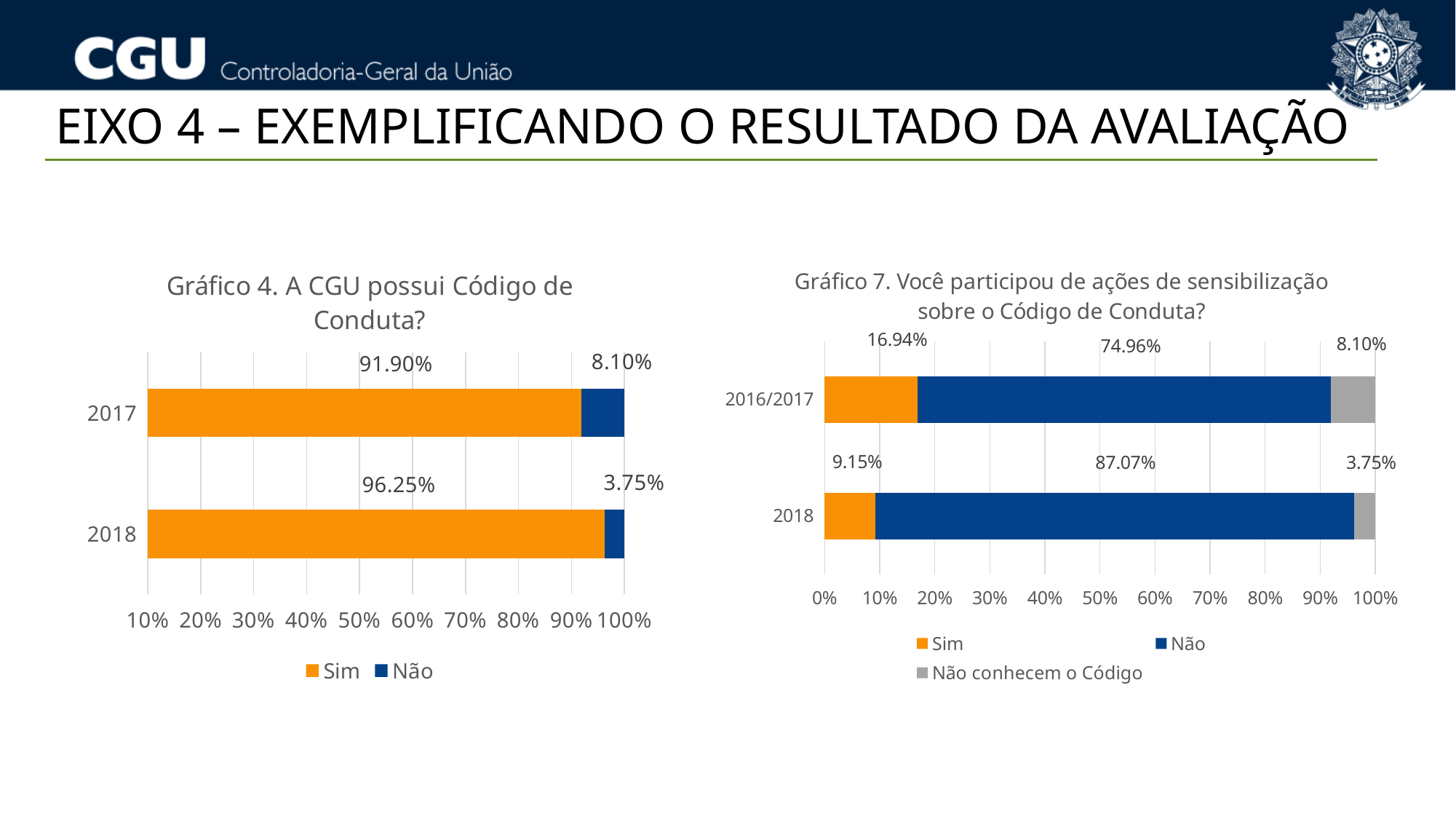
In Gráfico 7, what is the value for Sim in 2016/2017? 16.94% In Gráfico 7, how many series does the legend list? 3 In Gráfico 7, what is the value for Não in 2018? 87.07% In Gráfico 7, what is the difference between the Não values for 2018 and 2016/2017? 12.11% In Gráfico 4, which year has the higher Não value, 2017 or 2018? 2017 In Gráfico 4, what is the value for Sim in 2017? 91.90% In Gráfico 4, how many series does the legend list? 2 In Gráfico 7, what is the value for Não conhecem o Código in 2016/2017? 8.10% In Gráfico 4, what is the difference between the Sim values for 2018 and 2017? 4.35% In Gráfico 4, what is the value for Não in 2018? 3.75% What kind of chart is Gráfico 7? Stacked bar chart In Gráfico 7, which period has the higher Sim value, 2016/2017 or 2018? 2016/2017